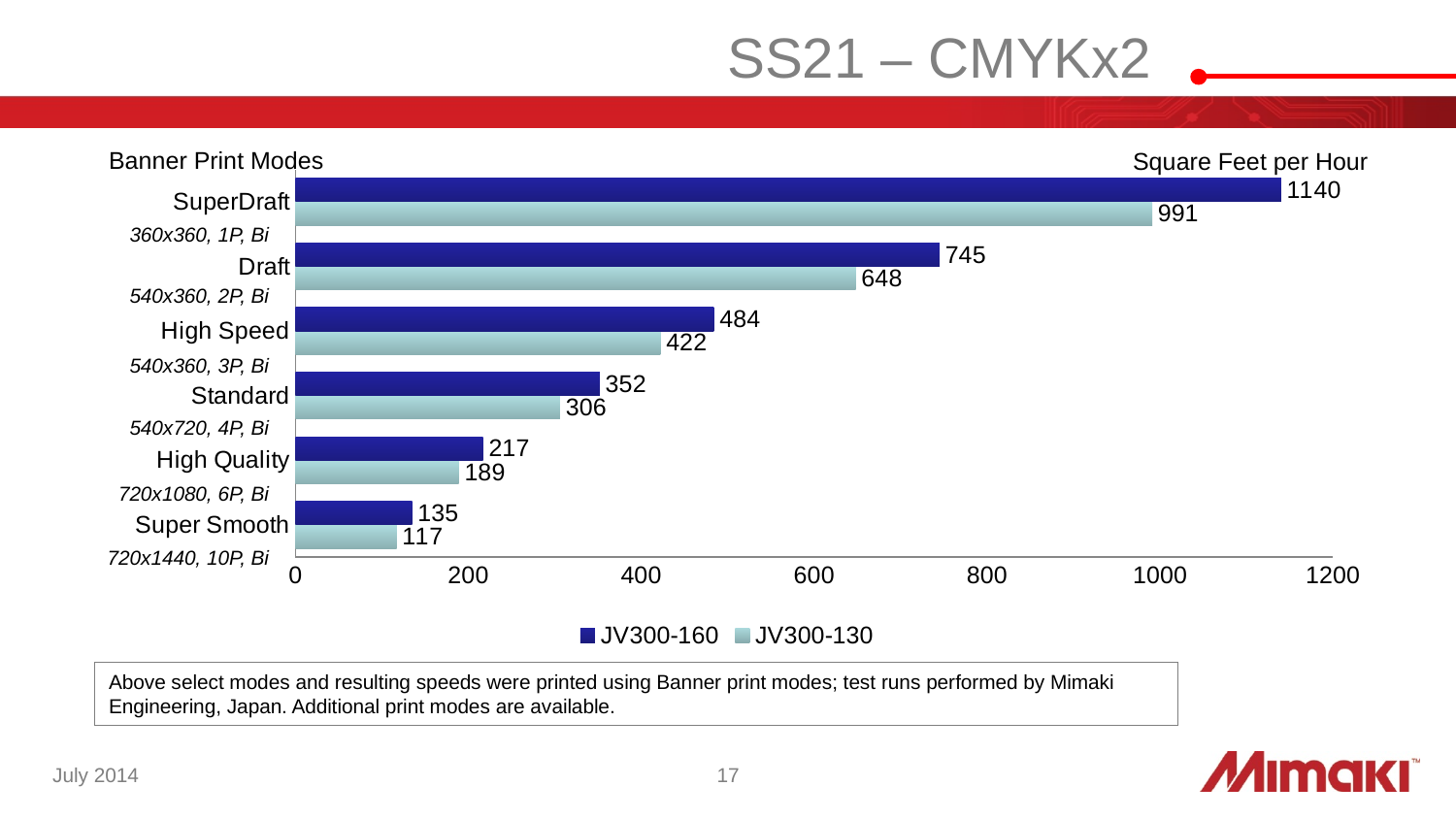
What kind of chart is shown on the slide? bar chart How many series does the legend list? 2 Which print mode has the lowest JV300-130 value? Super Smooth What is the difference between the JV300-160 and JV300-130 values for the Draft print mode? 97 How many print modes are shown on the chart? 6 What is the JV300-130 value for the Super Smooth print mode? 117 Is the JV300-130 value for SuperDraft greater or less than 1000? less What is the JV300-130 value for the High Speed print mode? 422 Which is larger for the Standard print mode, the JV300-160 value or the JV300-130 value? JV300-160 What is the JV300-160 value for the SuperDraft print mode? 1140 What is the label shown at the top right of the chart indicating the unit of measurement? Square Feet per Hour Which print mode has the highest JV300-160 value? SuperDraft